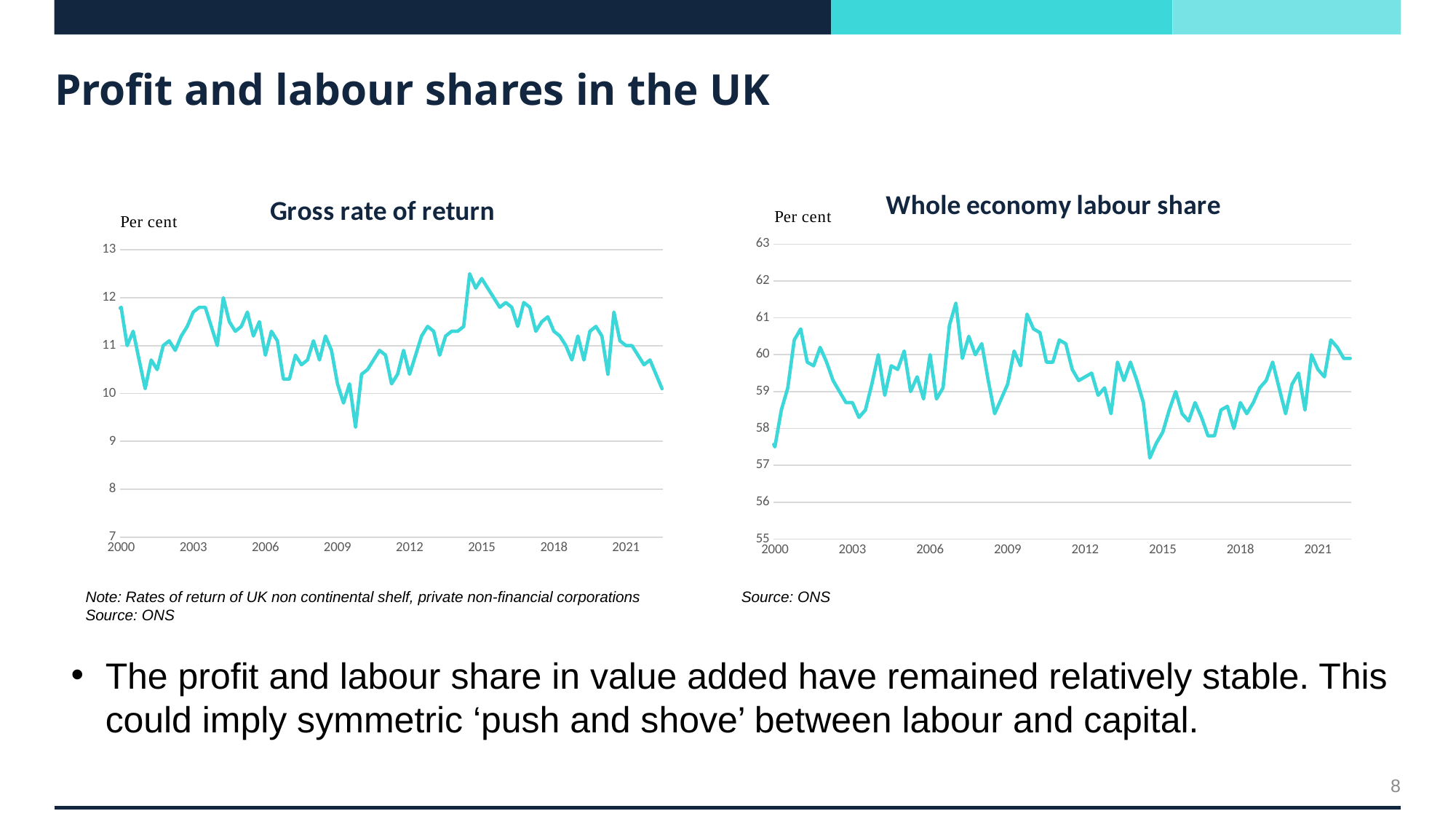
What kind of chart is the 'Gross rate of return' chart? line chart In the 'Whole economy labour share' chart, is the highest value of the line, around 2007, greater or less than 61? greater What unit is shown on the vertical axis of the 'Gross rate of return' chart? Per cent What kind of chart is the 'Whole economy labour share' chart? line chart In the 'Whole economy labour share' chart, does the line rise or fall between 2015 and 2021? rise In the 'Gross rate of return' chart, is the lowest value of the line, around 2009, greater or less than 10? less In the 'Gross rate of return' chart, is the peak value of the line, around 2015, greater or less than 12? greater What is the title of the chart on the right of the slide? Whole economy labour share In the 'Gross rate of return' chart, does the line rise or fall between 2015 and 2021? fall